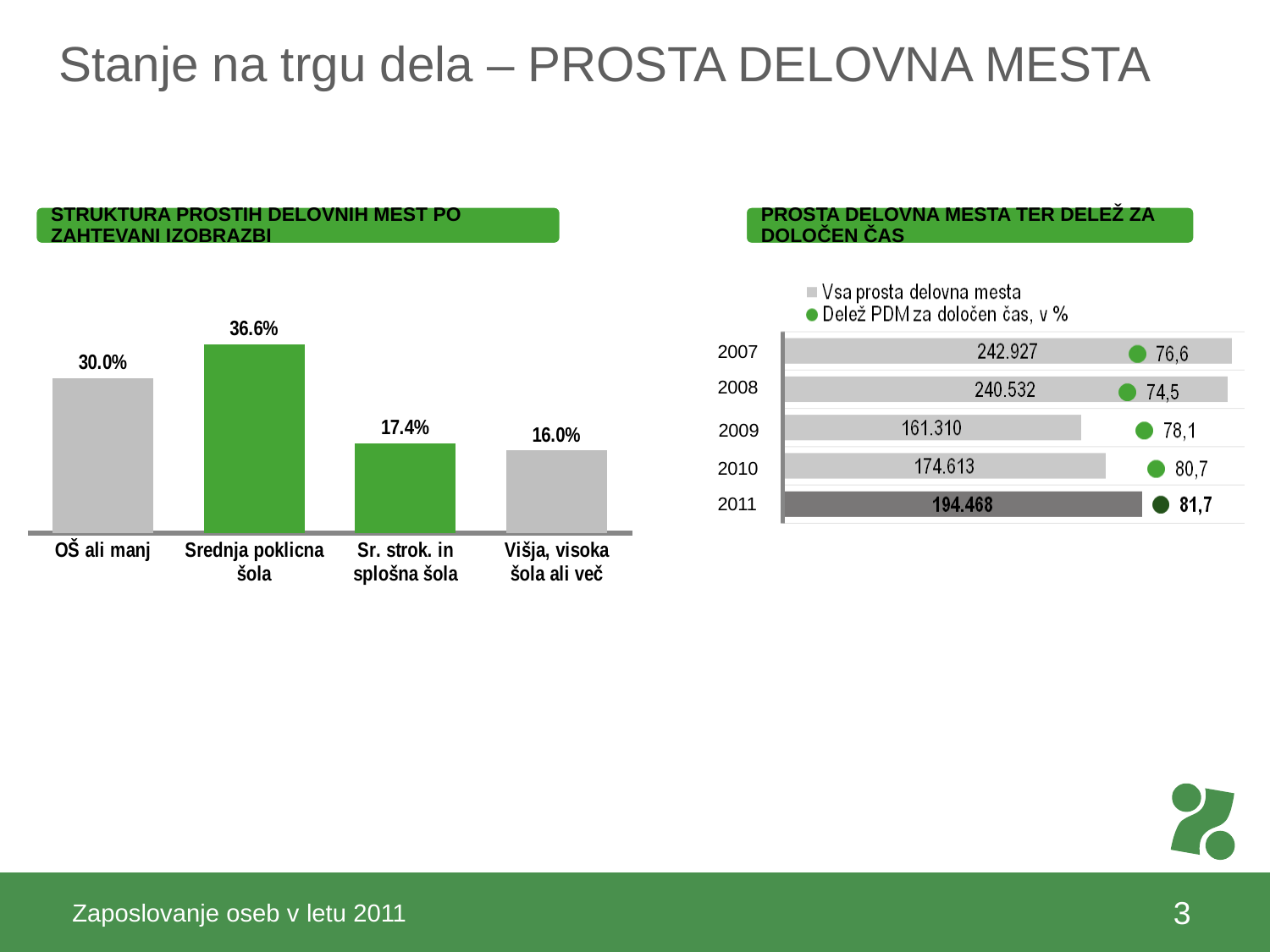
In the right chart (PROSTA DELOVNA MESTA TER DELEŽ ZA DOLOČEN ČAS), what is the value of Vsa prosta delovna mesta for 2009? 161.310 In the right chart (PROSTA DELOVNA MESTA TER DELEŽ ZA DOLOČEN ČAS), how many series does the legend list? 2 In the left chart (STRUKTURA PROSTIH DELOVNIH MEST PO ZAHTEVANI IZOBRAZBI), how many categories are shown? 4 In the left chart (STRUKTURA PROSTIH DELOVNIH MEST PO ZAHTEVANI IZOBRAZBI), what is the value for Srednja poklicna šola? 36.6% In the right chart (PROSTA DELOVNA MESTA TER DELEŽ ZA DOLOČEN ČAS), which year has the highest value of Vsa prosta delovna mesta? 2007 In the right chart (PROSTA DELOVNA MESTA TER DELEŽ ZA DOLOČEN ČAS), which year has the lowest Delež PDM za določen čas? 2008 In the left chart (STRUKTURA PROSTIH DELOVNIH MEST PO ZAHTEVANI IZOBRAZBI), which category has the highest value? Srednja poklicna šola In the left chart (STRUKTURA PROSTIH DELOVNIH MEST PO ZAHTEVANI IZOBRAZBI), what is the difference between the values for OŠ ali manj and Sr. strok. in splošna šola? 12.6% What kind of chart is the left chart (STRUKTURA PROSTIH DELOVNIH MEST PO ZAHTEVANI IZOBRAZBI)? Bar chart In the right chart (PROSTA DELOVNA MESTA TER DELEŽ ZA DOLOČEN ČAS), is the value of Vsa prosta delovna mesta larger for 2010 or 2011? 2011 In the left chart (STRUKTURA PROSTIH DELOVNIH MEST PO ZAHTEVANI IZOBRAZBI), which category has the lowest value? Višja, visoka šola ali več In the right chart (PROSTA DELOVNA MESTA TER DELEŽ ZA DOLOČEN ČAS), what is the Delež PDM za določen čas for 2011? 81,7